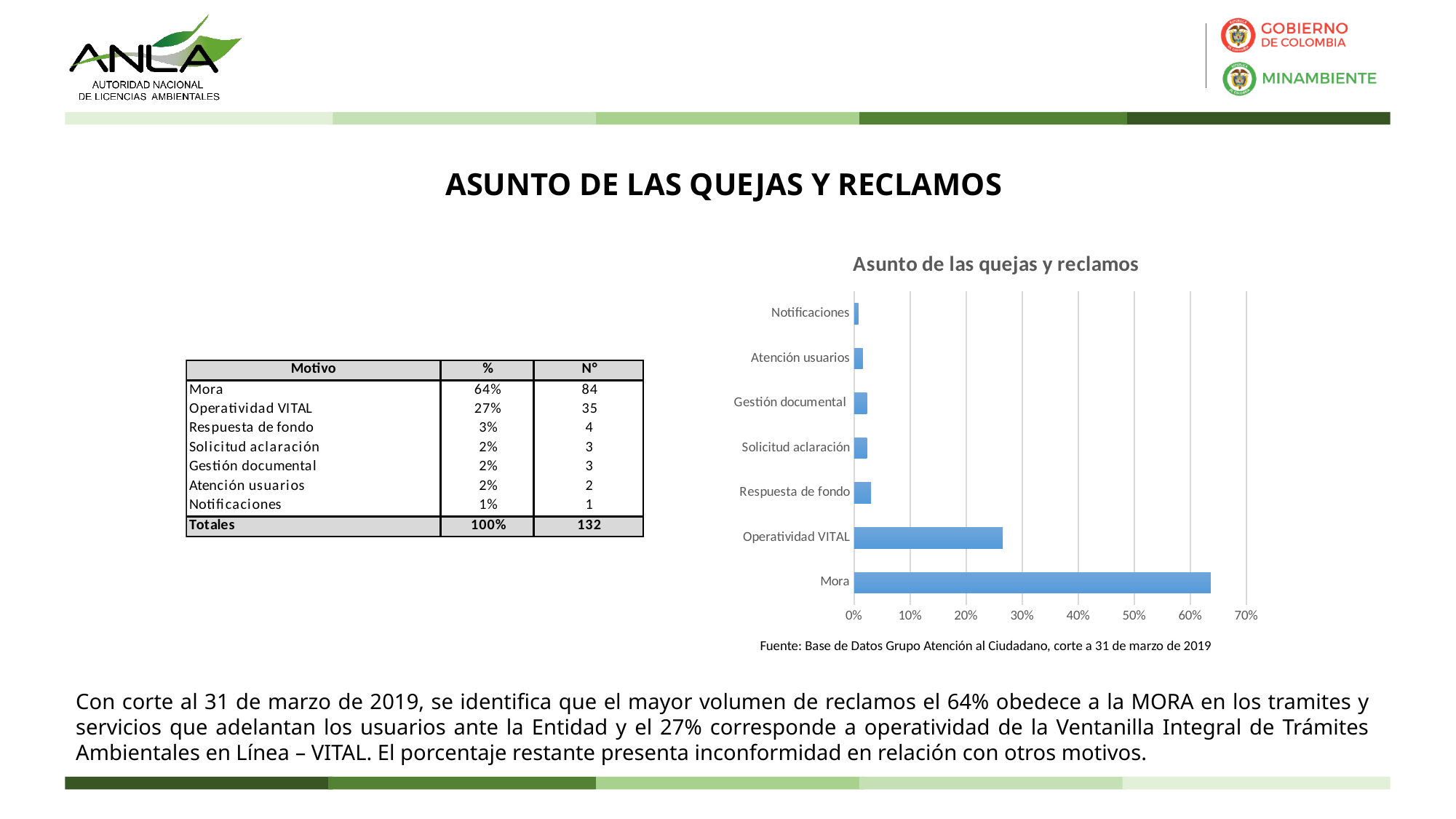
What is the difference between the percentage for Mora and the percentage for Operatividad VITAL? 37% What kind of chart is shown on the slide? Bar chart Is the value for Mora greater or less than 60%? greater Which category has the lowest value in the chart? Notificaciones Is the value for Respuesta de fondo greater or less than 10%? less What is the title of the chart? Asunto de las quejas y reclamos Which category has the highest value in the chart? Mora How many categories are plotted in the chart? 7 What percentage is shown for Mora? 64% Which is larger, the value for Operatividad VITAL or the value for Respuesta de fondo? Operatividad VITAL Is the value for Operatividad VITAL greater or less than 30%? less What percentage is shown for Operatividad VITAL? 27%